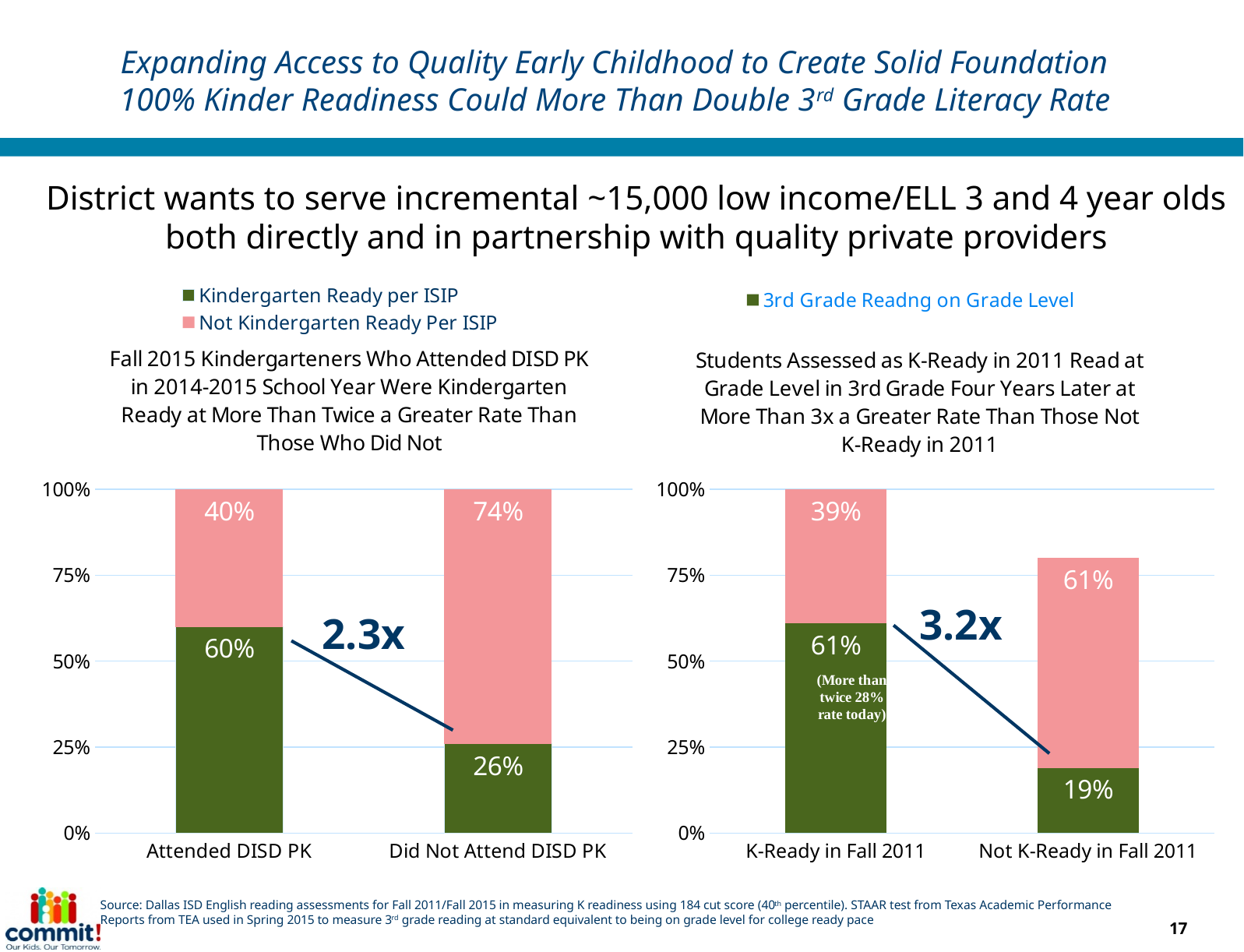
In the right chart, what is the difference in the 3rd grade reading on grade level rate between K-Ready and Not K-Ready students? 42 percentage points How many series does the legend of the left chart list? 2 In the right chart, what percentage of students K-Ready in Fall 2011 were reading on grade level in 3rd grade? 61% What multiplier is annotated between the two bars in the right chart? 3.2x In the left chart, what is the difference in the Kindergarten Ready per ISIP rate between those who attended DISD PK and those who did not? 34 percentage points How many categories are shown on the x axis of the left chart? 2 In the right chart, which category has the lowest 3rd grade reading on grade level rate? Not K-Ready in Fall 2011 In the left chart, which category has the higher Kindergarten Ready per ISIP rate? Attended DISD PK In the right chart, what percentage of students Not K-Ready in Fall 2011 were reading on grade level in 3rd grade? 19% In the left chart, what percentage of kindergarteners who did not attend DISD PK were Not Kindergarten Ready per ISIP? 74% What kind of chart is the right chart? Stacked bar chart In the left chart, what percentage of kindergarteners who attended DISD PK were Kindergarten Ready per ISIP? 60%